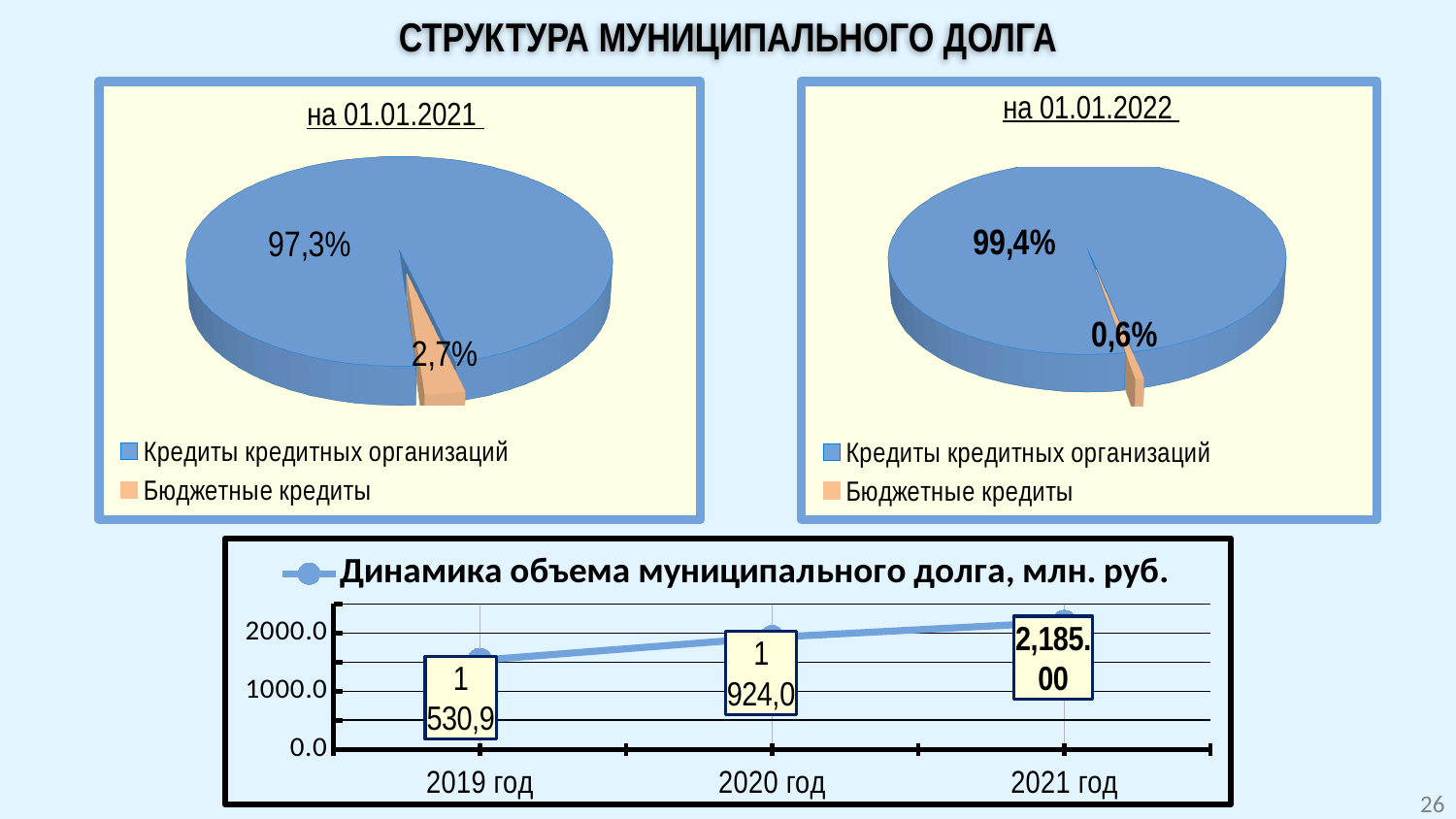
In the pie chart 'на 01.01.2021', how many categories does the legend list? 2 In the chart 'Динамика объема муниципального долга, млн. руб.', what is the value for 2019 год? 1 530,9 In the chart 'Динамика объема муниципального долга, млн. руб.', how many data points are plotted? 3 In the pie chart 'на 01.01.2022', what share is shown for Кредиты кредитных организаций? 99,4% In the chart 'Динамика объема муниципального долга, млн. руб.', what is the value for 2021 год? 2,185.00 In the chart 'Динамика объема муниципального долга, млн. руб.', do the values rise or fall from 2019 год to 2021 год? rise In the pie chart 'на 01.01.2022', which category has the smallest slice? Бюджетные кредиты In the pie chart 'на 01.01.2021', what share is shown for Бюджетные кредиты? 2,7% What type of chart is used for 'на 01.01.2021'? pie chart In the chart 'Динамика объема муниципального долга, млн. руб.', what is the value for 2020 год? 1 924,0 In the pie chart 'на 01.01.2021', what share is shown for Кредиты кредитных организаций? 97,3%